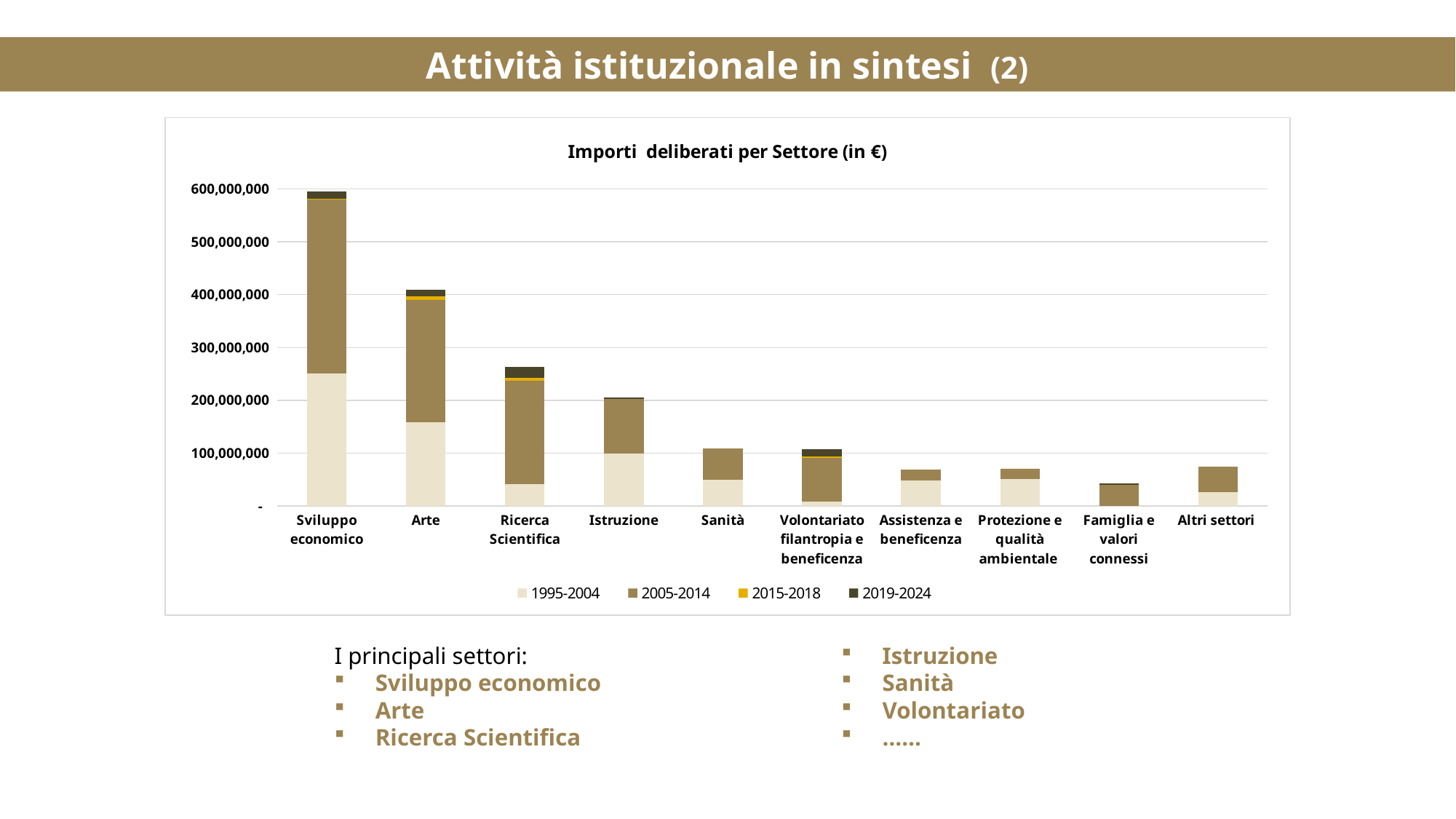
How many series does the chart's legend list? 4 Is the total value for Ricerca Scientifica greater or less than 200,000,000? greater Is the total value for Altri settori greater or less than 100,000,000? less Which period does the first legend entry of the chart refer to? 1995-2004 Which has a larger total amount, Istruzione or Sanità? Istruzione What kind of chart is shown on the slide? Stacked bar chart Is the total value for Sviluppo economico greater or less than 500,000,000? greater Which sector has the lowest total amount in the chart? Famiglia e valori connessi Which has a larger total amount, Arte or Ricerca Scientifica? Arte How many sectors (categories) are shown on the x axis of the chart? 10 What is the title of the chart? Importi deliberati per Settore (in €) Which sector has the highest total amount in the chart? Sviluppo economico